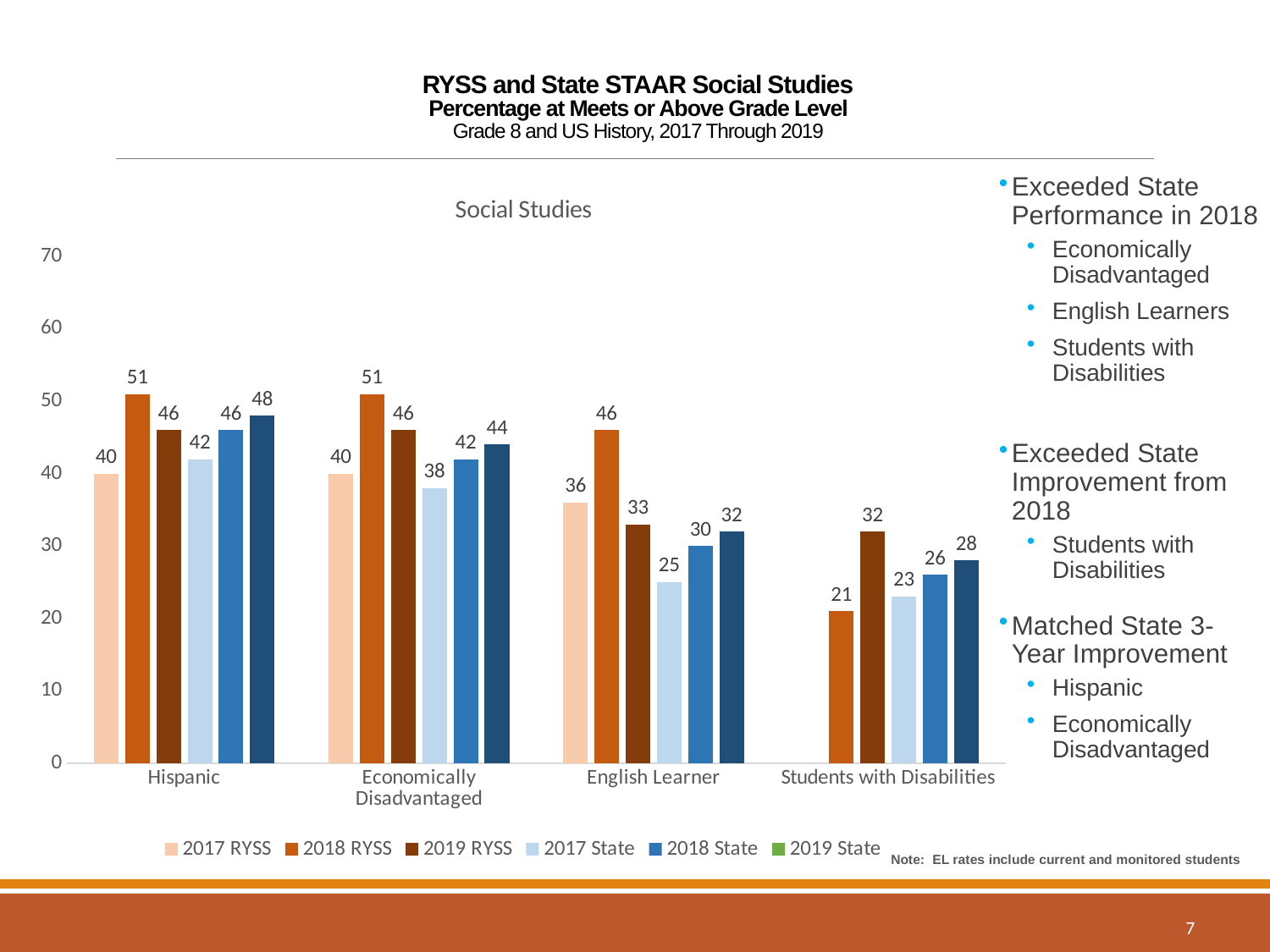
What is the title of the chart? Social Studies What is the difference between the 2018 RYSS and 2019 RYSS values for English Learner? 13 How many series does the legend list? 6 What is the 2019 RYSS value for Students with Disabilities? 32 What is the 2018 RYSS value for Hispanic? 51 For Hispanic, which is larger: the 2017 RYSS value or the 2017 State value? 2017 State How many categories are shown on the x axis? 4 What is the 2017 State value for English Learner? 25 What kind of chart is shown on the slide? Bar chart What is the difference between the 2019 RYSS and 2018 State values for Economically Disadvantaged? 4 Do the 2017 State values rise or fall moving from Hispanic to Students with Disabilities? Fall Which category has the lowest 2018 RYSS value? Students with Disabilities